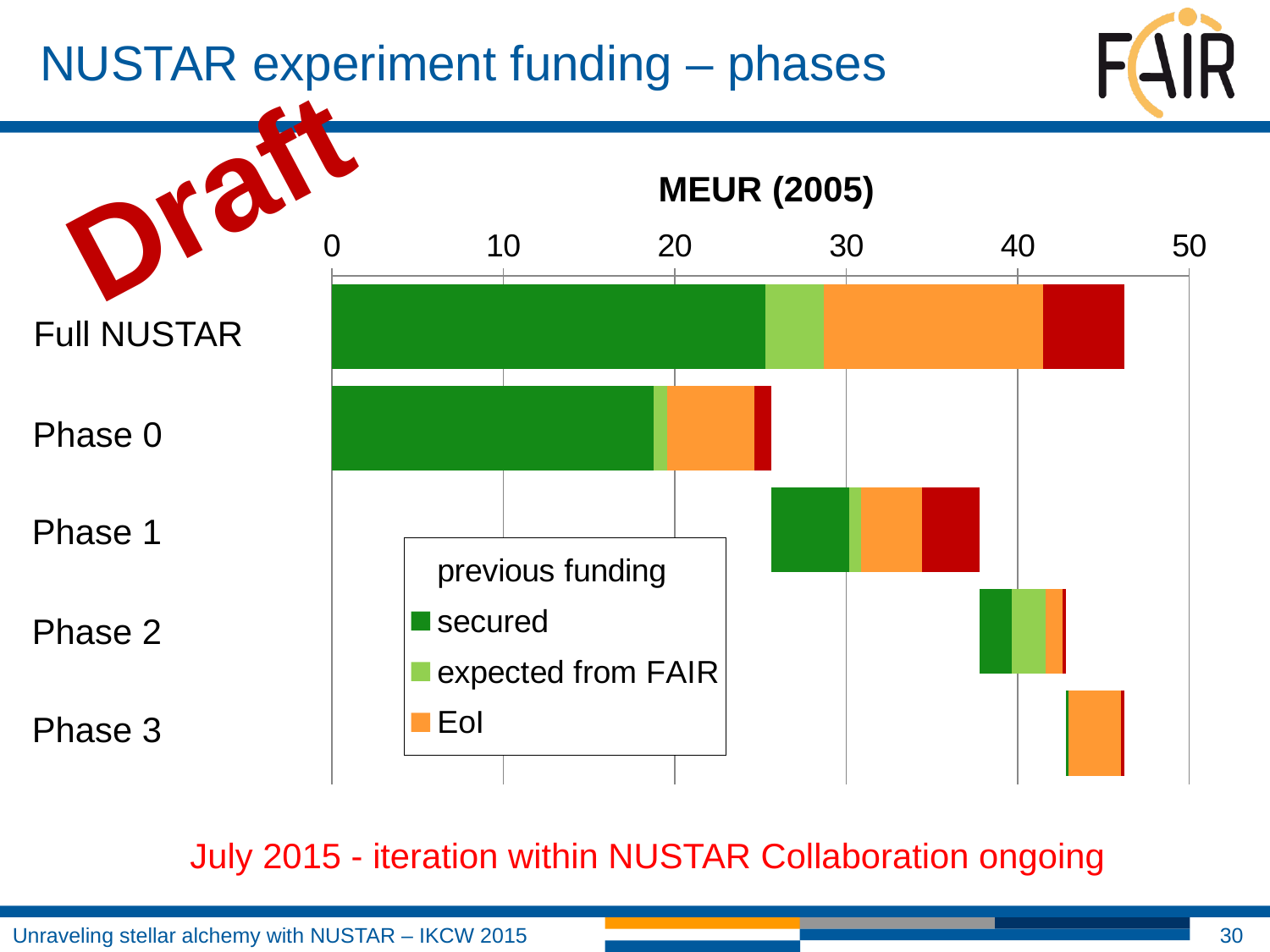
Is the right end of the Phase 0 bar greater or less than 20? greater What kind of chart is shown on the slide? bar chart Which legend entry is shown in orange? EoI Which category has the longest bar on the chart? Full NUSTAR Which bar is longer, Phase 0 or Phase 1? Phase 0 Is the secured segment of the Full NUSTAR bar greater or less than 20? greater How many categories (bars) are shown on the chart? 5 Is the right end of the Full NUSTAR bar greater or less than 40? greater What is the title of the chart's horizontal axis? MEUR (2005)